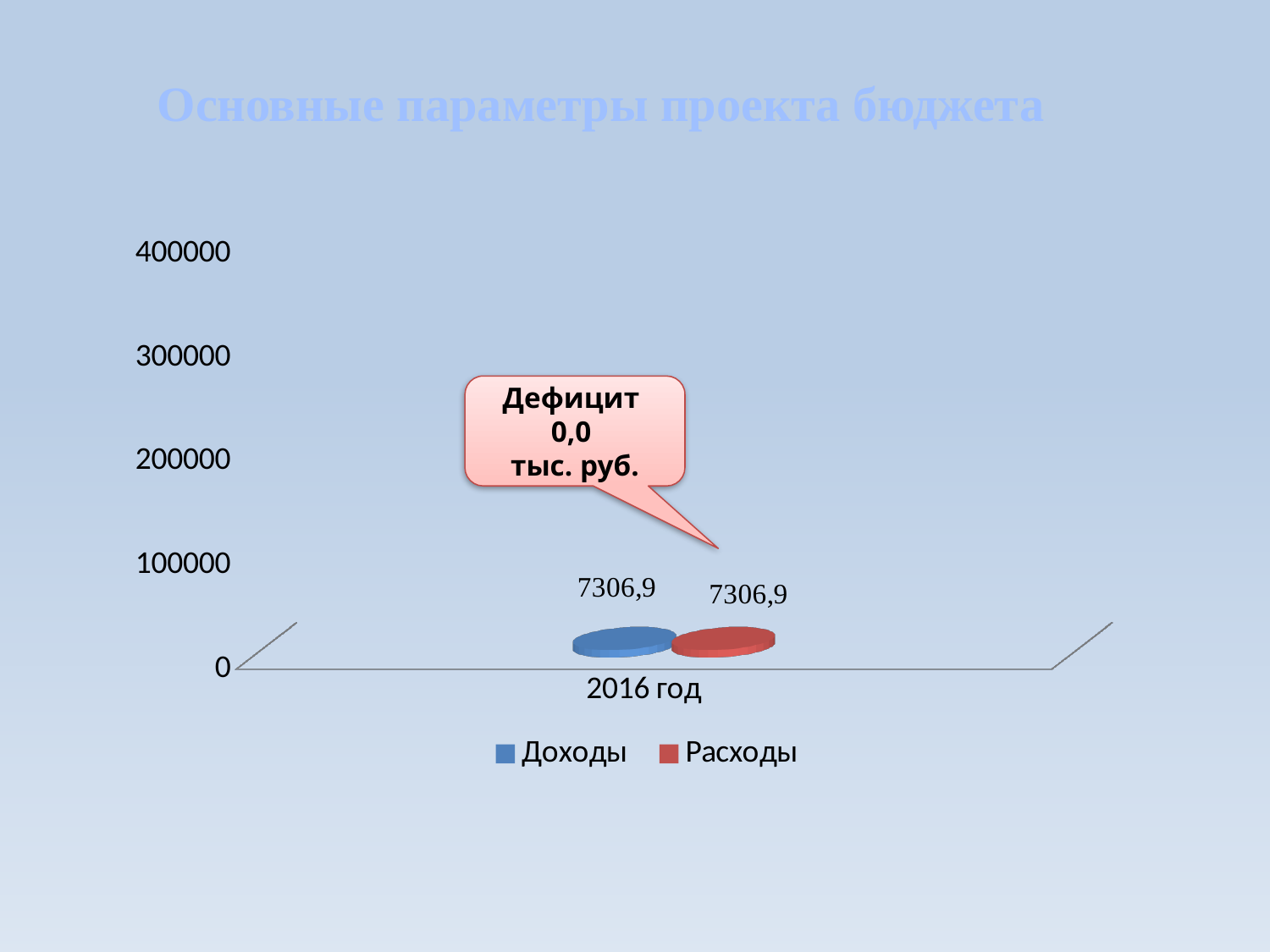
How many series does the legend list? 2 Is the value for Расходы in 2016 год greater or less than 100000? less What is the title of the slide? Основные параметры проекта бюджета Which category label appears on the x axis? 2016 год How many categories are shown on the x axis? 1 What kind of chart is shown on the slide? bar chart What is the value for Расходы in 2016 год? 7306,9 What deficit value is shown in the callout on the chart? 0,0 тыс. руб. What is the difference between Расходы and Доходы for 2016 год? 0,0 What is the value for Доходы in 2016 год? 7306,9 Is the value for Доходы in 2016 год greater or less than 100000? less What is the highest value shown on the vertical axis? 400000